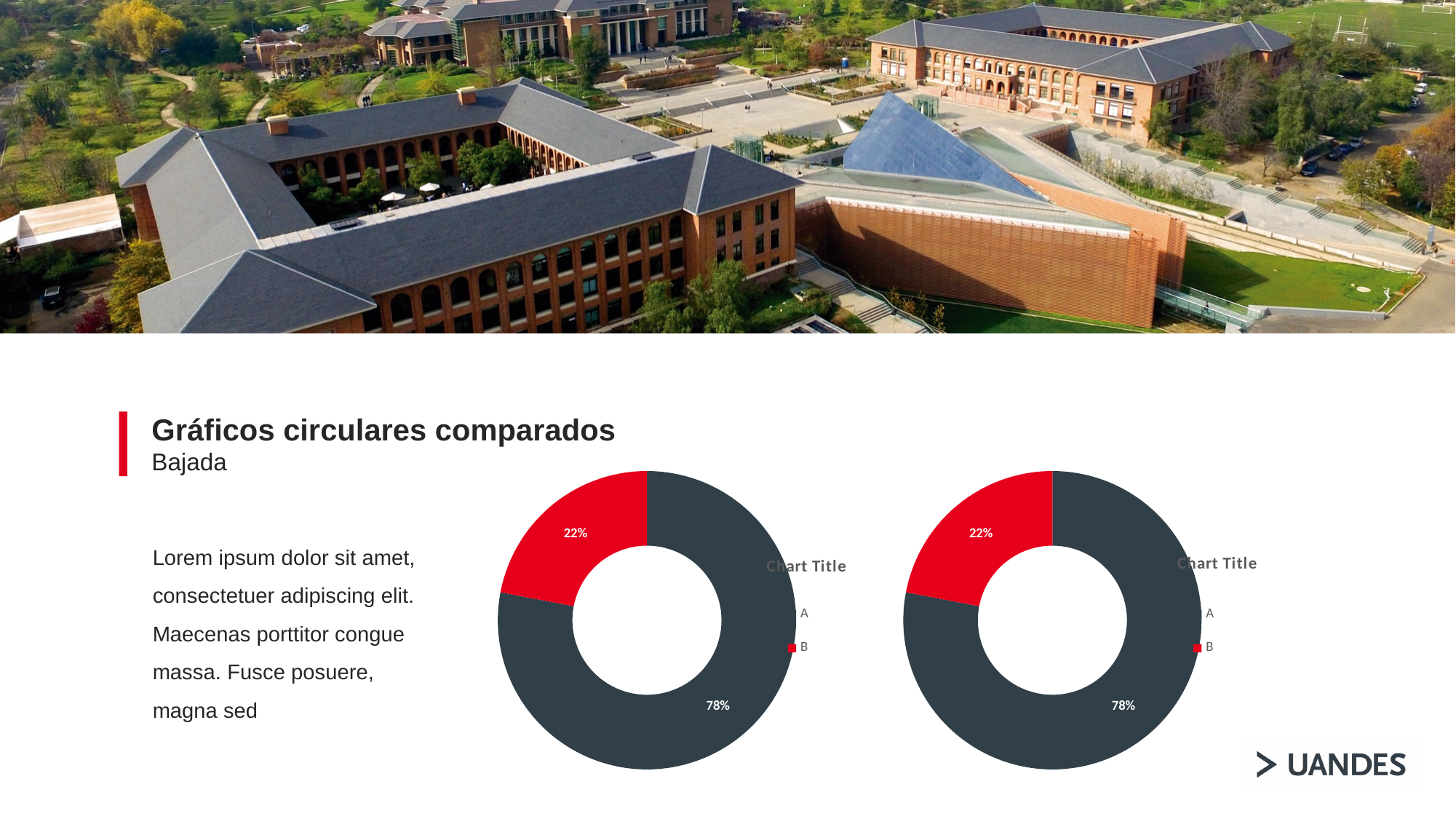
In the left chart, what is the value for category A? 78% What kind of chart is the right chart? Donut (pie) chart In the right chart, what is the value for category B? 22% In the right chart, which category has the smallest share? B How many categories does the legend of the left chart list? 2 In the left chart, what is the value for category B? 22% What colour is the slice for category B in the left chart? Red In the left chart, which category has the largest share? A In the left chart, what is the difference between the shares of A and B? 56% What is the title shown on the right chart? Chart Title In the right chart, what is the value for category A? 78% In the right chart, which is larger, the share of A or the share of B? A